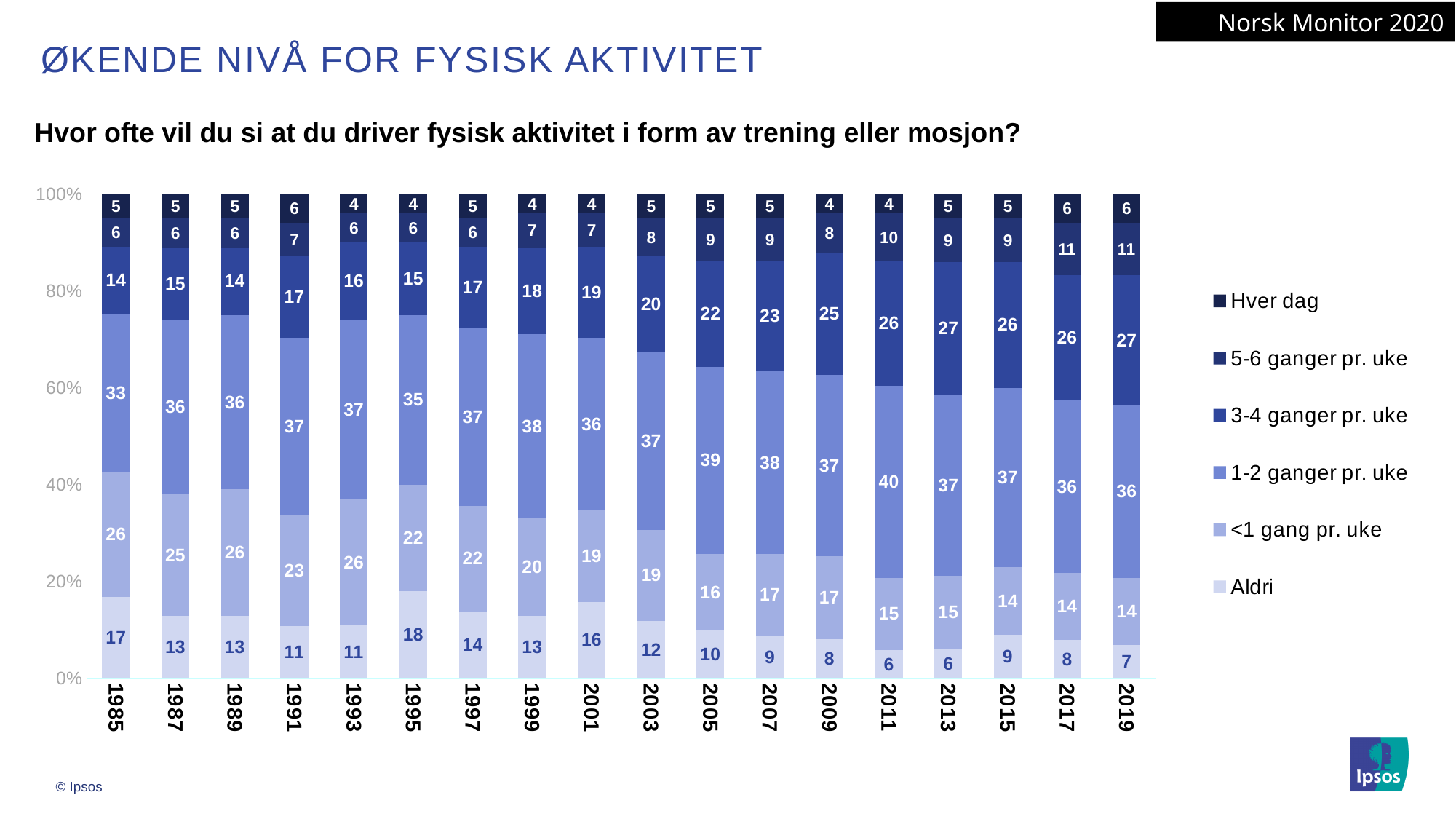
In which year is the value for "Aldri" highest? 1995 What is the value for "Hver dag" in 2017? 6 How many series does the legend list? 6 Which year has the larger value for "Aldri", 1985 or 2019? 1985 What is the difference between the "3-4 ganger pr. uke" values for 2019 and 1985? 13 What kind of chart is shown on the slide? Stacked bar chart Do the values for "3-4 ganger pr. uke" generally rise or fall from 1985 to 2019? Rise How many years are shown on the x axis? 18 What is the value for "Aldri" in 1985? 17 In which year is the value for "1-2 ganger pr. uke" highest? 2011 What is the value for "3-4 ganger pr. uke" in 2019? 27 What is the total of the stacked bar for 1987? 100